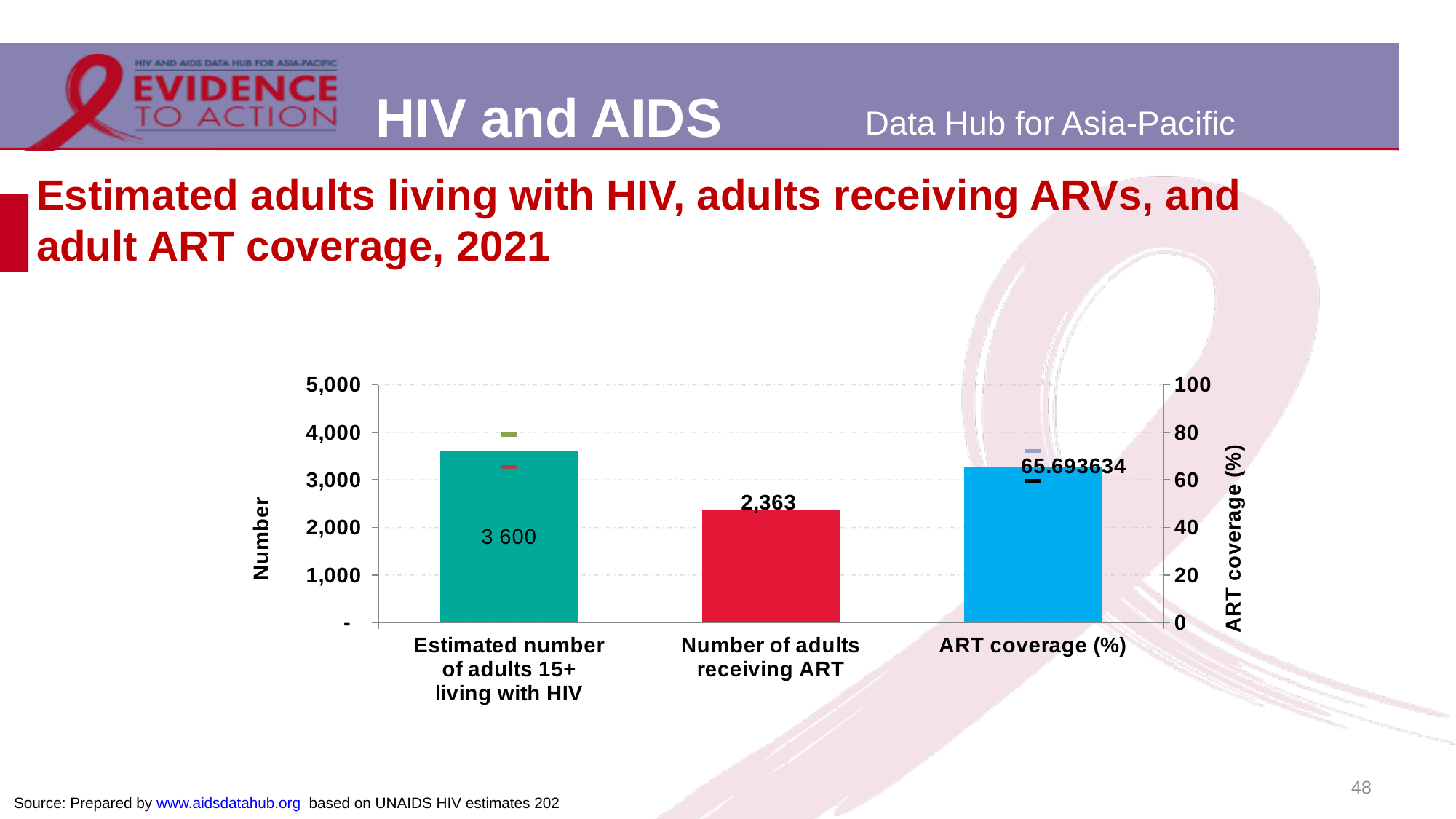
What is the label of the right-hand vertical axis? ART coverage (%) How many categories are shown on the x axis of the chart? 3 What is the ART coverage (%) value shown on the chart? 65.693634 Which is larger: the estimated number of adults 15+ living with HIV or the number of adults receiving ART? Estimated number of adults 15+ living with HIV What is the difference between the estimated number of adults 15+ living with HIV and the number of adults receiving ART? 1,237 What is the label of the left-hand vertical axis? Number What is the number of adults receiving ART shown on the chart? 2,363 Is the number of adults receiving ART greater or less than 3,000? less What is the estimated number of adults 15+ living with HIV shown on the chart? 3 600 Is the ART coverage (%) value greater or less than 60 on the right-hand axis? greater What kind of chart is shown on the slide? Bar chart